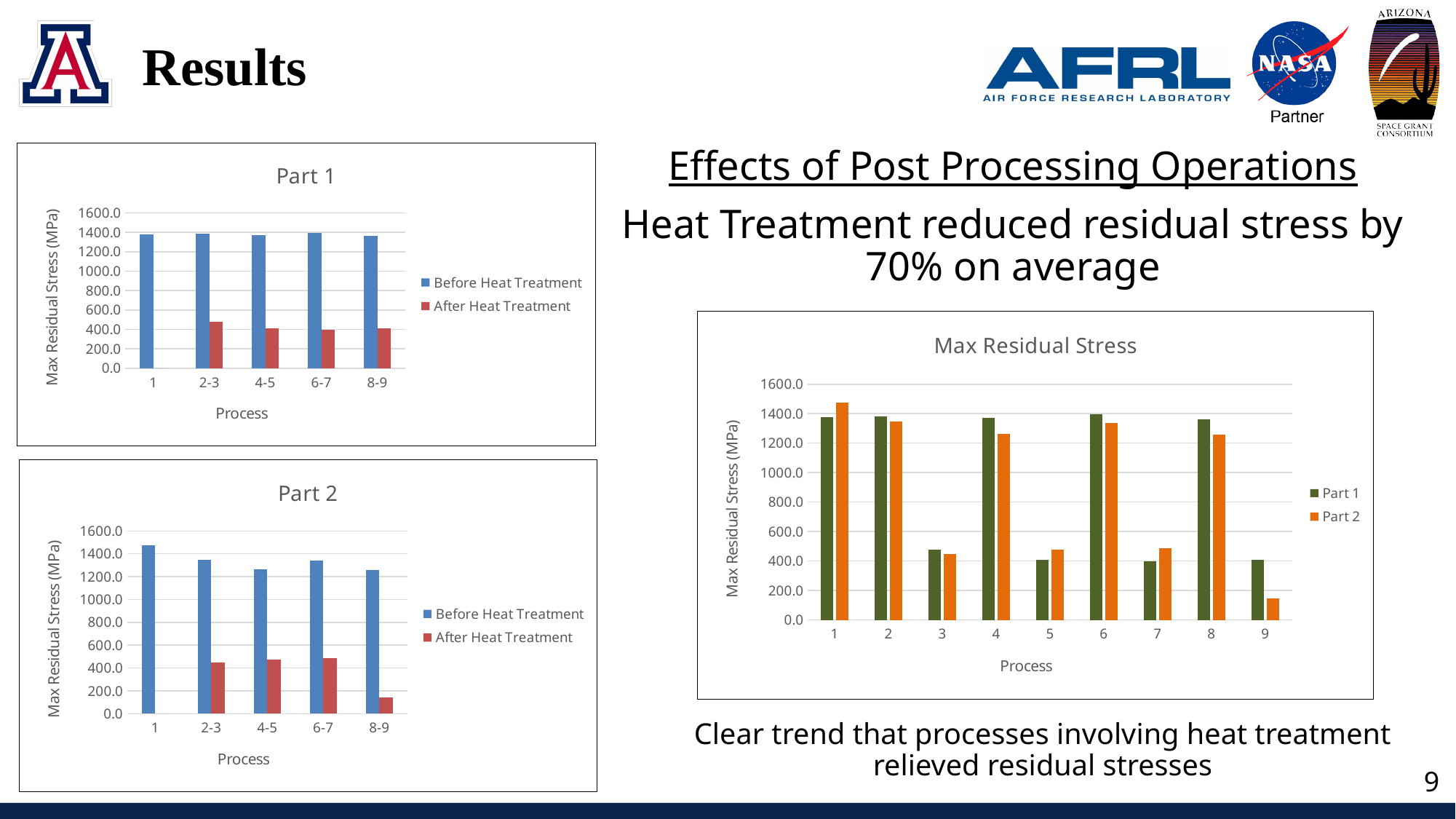
What is the y-axis label of the "Max Residual Stress" chart? Max Residual Stress (MPa) In the "Part 1" chart, is the After Heat Treatment value for process 2-3 greater or less than 400? greater In the "Part 2" chart, which process has the highest Before Heat Treatment value? 1 How many process categories are shown on the x axis of the "Part 1" chart? 5 What kind of chart is the "Part 1" chart? bar chart How many series does the legend of the "Part 1" chart list? 2 How many processes are shown on the x axis of the "Max Residual Stress" chart? 9 In the "Part 1" chart, is the Before Heat Treatment value for process 1 greater or less than 1200? greater In the "Max Residual Stress" chart, for process 4, which is larger: Part 1 or Part 2? Part 1 In the "Max Residual Stress" chart, for process 1, which is larger: Part 1 or Part 2? Part 2 In the "Part 2" chart, is the After Heat Treatment value for process 8-9 greater or less than 200? less